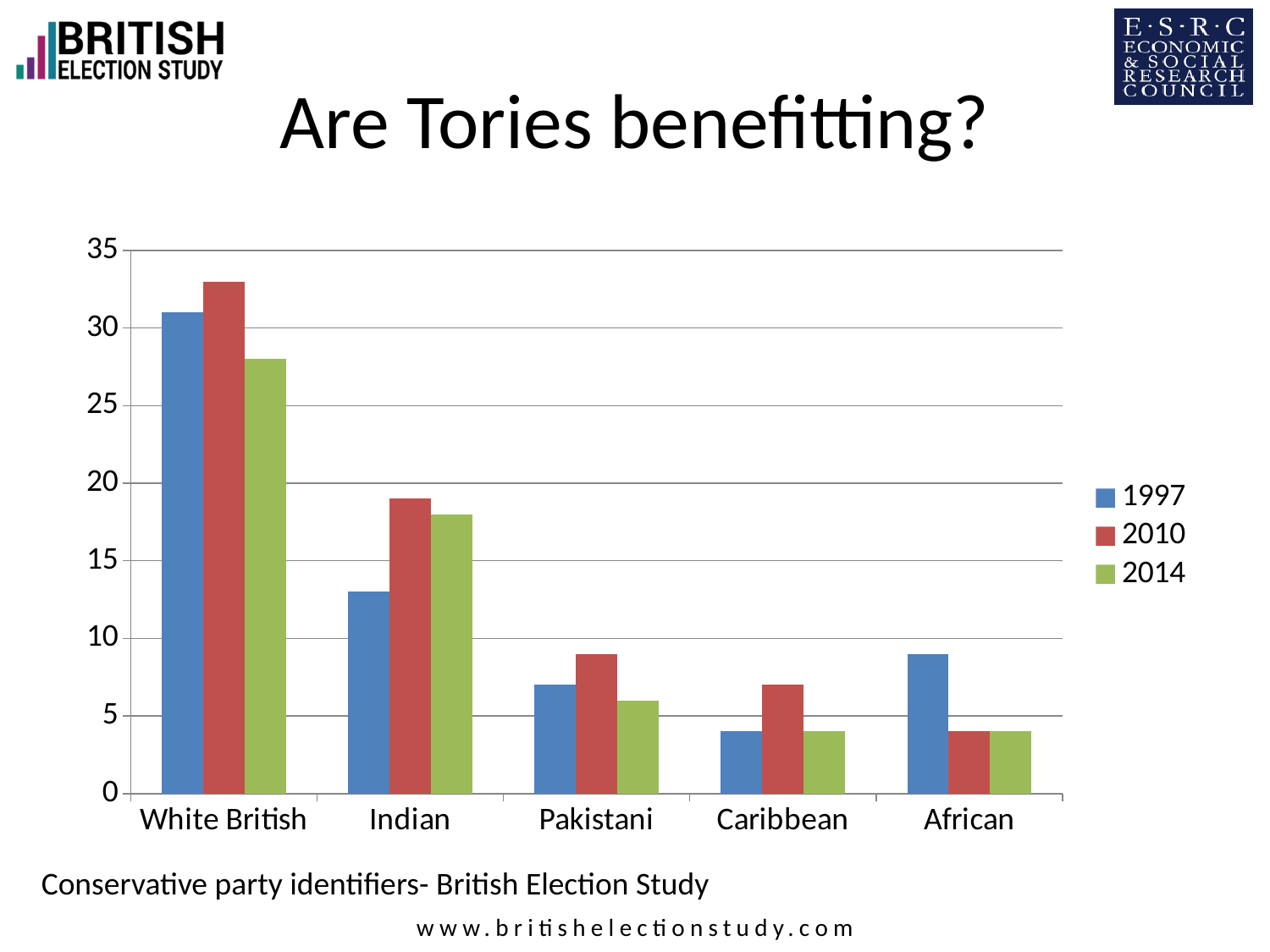
Is the value for Pakistani in 2010 greater or less than 10? less Is the value for White British in 2010 greater or less than 30? greater Which series is shown in green in the legend? 2014 For the African category, which is larger: the 1997 value or the 2014 value? 1997 Which category has the highest value for the 2010 series? White British Is the value for African in 1997 greater or less than 5? greater How many ethnic group categories are shown on the x axis? 5 Which category has the lowest value for the 1997 series? Caribbean For the Indian category, which is larger: the 1997 value or the 2010 value? 2010 How many series does the legend list? 3 What kind of chart is shown on the slide? bar chart